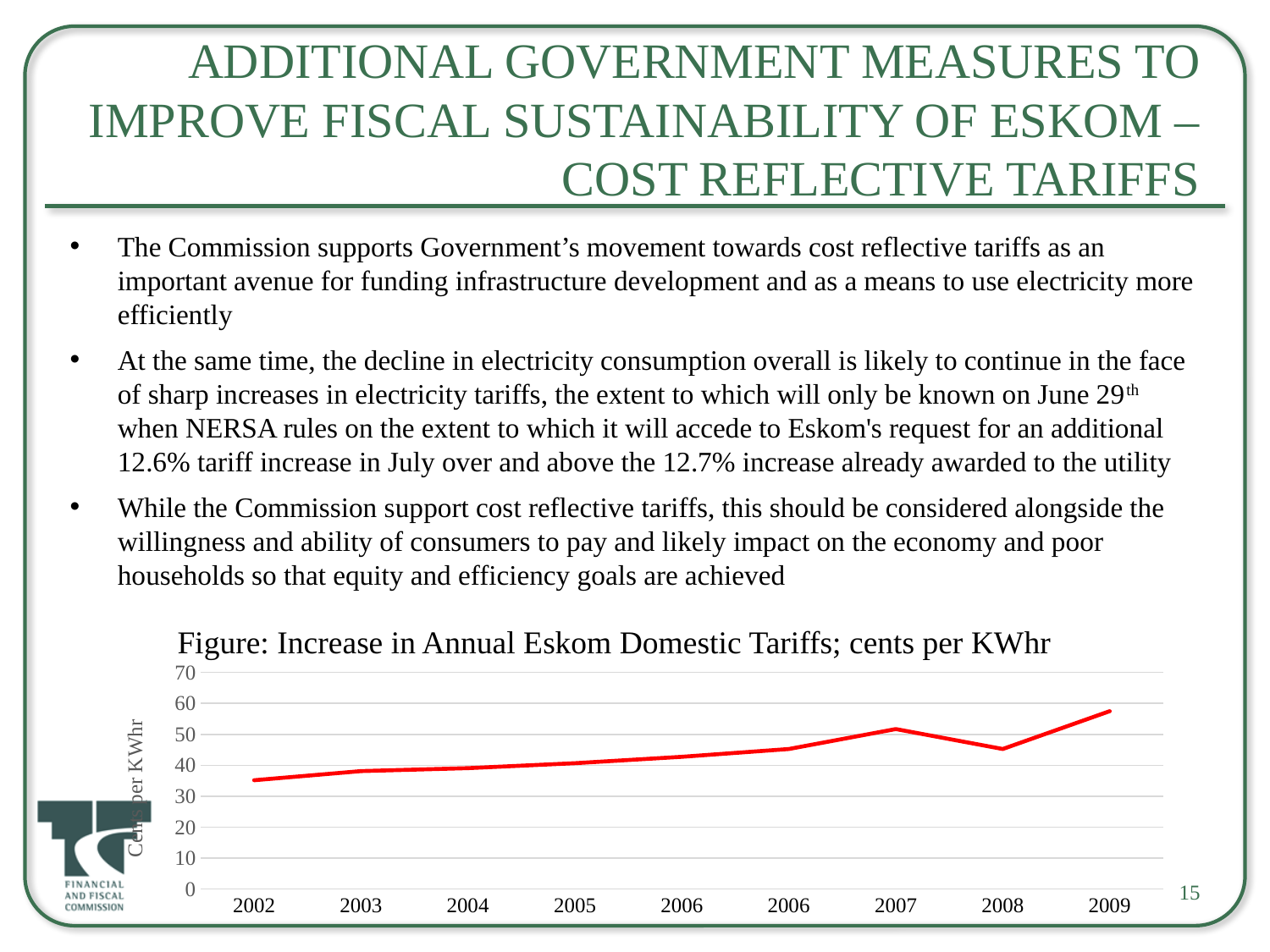
Is the value for 2003 greater or less than 40? less Is the value for 2002 greater or less than 40? less Which year has the lowest tariff value in the chart? 2002 Is the value for 2009 greater or less than 50? greater Which year has the larger tariff value, 2007 or 2008? 2007 What is the label on the vertical axis of the chart? Cents per KWhr What kind of chart is shown on the slide? line chart What is the title of the chart on the slide? Figure: Increase in Annual Eskom Domestic Tariffs; cents per KWhr How many data points are plotted on the line in the chart? 9 Which year has the highest tariff value in the chart? 2009 Overall, do the tariff values rise or fall from 2002 to 2009? rise